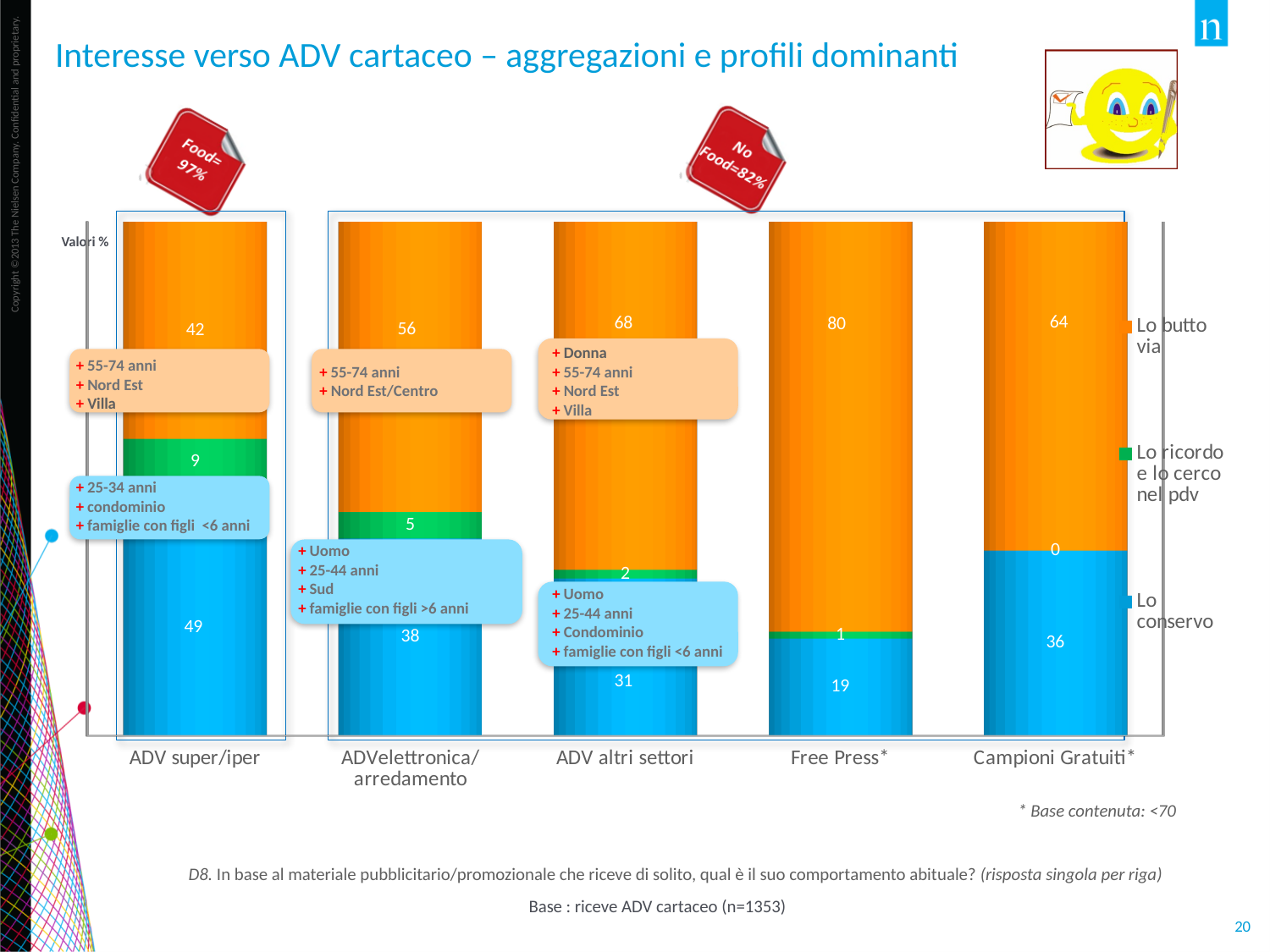
Which is larger: "Lo conservo" for ADVelettronica/arredamento or for Campioni Gratuiti*? ADVelettronica/arredamento Which category has the lowest value for "Lo conservo"? Free Press* What is the total of the stacked bar for ADV altri settori? 101 What is the value of "Lo conservo" for ADV super/iper? 49 How many series does the legend list? 3 What is the value of "Lo ricordo e lo cerco nel pdv" for ADVelettronica/arredamento? 5 What kind of chart is shown on the slide? Stacked bar chart Which category has the highest value for "Lo butto via"? Free Press* What is the value of "Lo butto via" for Free Press*? 80 What is the value of "Lo ricordo e lo cerco nel pdv" for Campioni Gratuiti*? 0 How many categories are shown on the x axis? 5 What is the difference between the "Lo butto via" values for ADV altri settori and ADV super/iper? 26